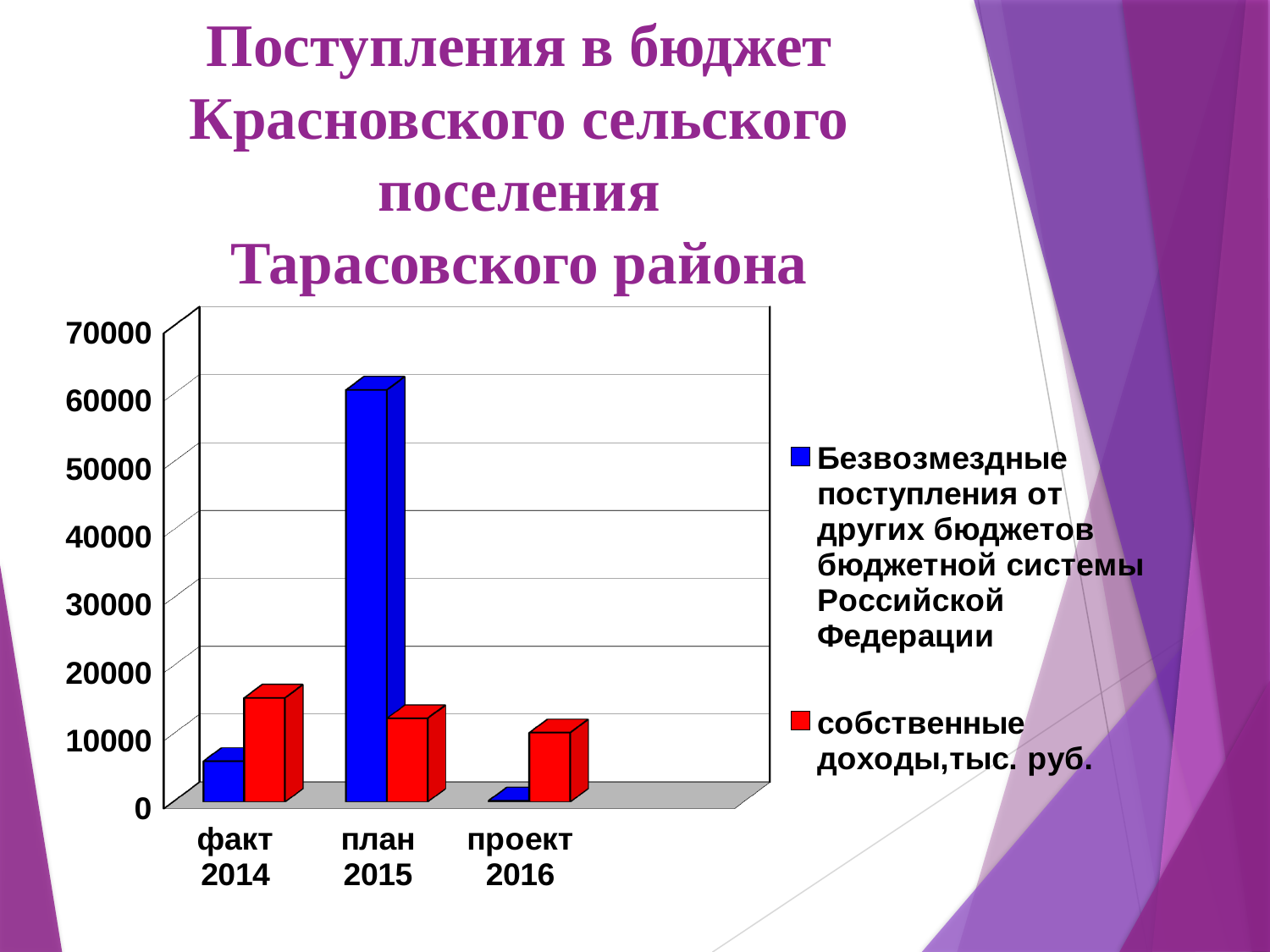
What kind of chart is shown on the slide? bar chart Is the value for 'Безвозмездные поступления от других бюджетов бюджетной системы Российской Федерации' in факт 2014 greater or less than 10000? less In which category is the value for 'собственные доходы,тыс. руб.' highest? факт 2014 How many categories are shown on the x axis of the chart? 3 Is the value for 'Безвозмездные поступления от других бюджетов бюджетной системы Российской Федерации' in план 2015 greater or less than 50000? greater Which colour represents 'собственные доходы,тыс. руб.' in the chart? red In which category is the value for 'Безвозмездные поступления от других бюджетов бюджетной системы Российской Федерации' lowest? проект 2016 In план 2015, which series has the larger value: 'Безвозмездные поступления от других бюджетов бюджетной системы Российской Федерации' or 'собственные доходы,тыс. руб.'? Безвозмездные поступления от других бюджетов бюджетной системы Российской Федерации In which category is the value for 'Безвозмездные поступления от других бюджетов бюджетной системы Российской Федерации' highest? план 2015 How many series does the chart's legend list? 2 In факт 2014, which series has the larger value: 'Безвозмездные поступления от других бюджетов бюджетной системы Российской Федерации' or 'собственные доходы,тыс. руб.'? собственные доходы,тыс. руб. Is the value for 'собственные доходы,тыс. руб.' in факт 2014 greater or less than 10000? greater